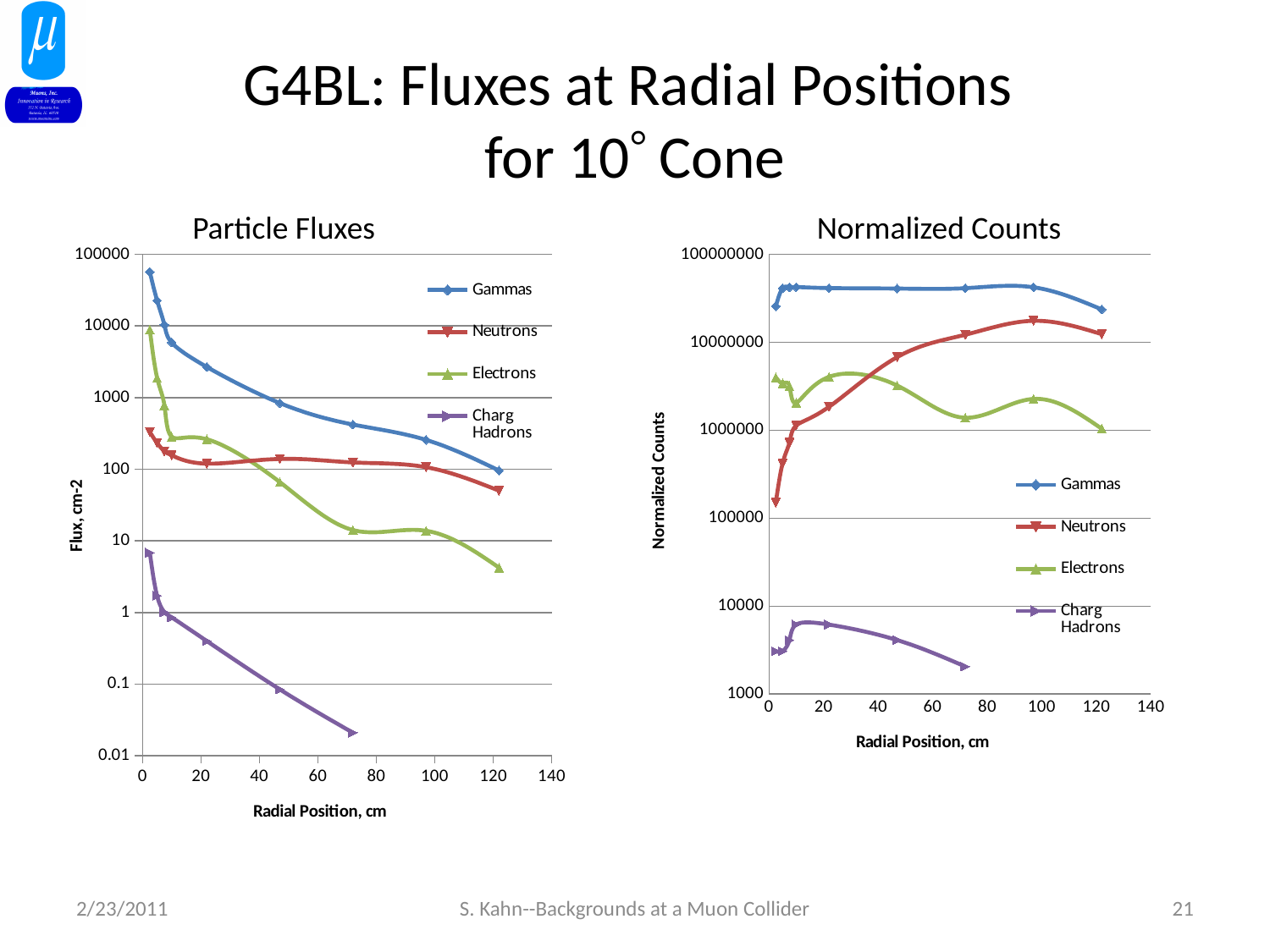
In the Particle Fluxes chart, do the Gammas values rise or fall as radial position increases? fall What kind of chart is the Particle Fluxes chart on the left? line chart In the Particle Fluxes chart, which series has the highest flux at the largest radial position (about 120 cm)? Gammas In the Particle Fluxes chart, is the Gammas flux at a radial position of about 20 cm greater or less than 1000? greater In the Normalized Counts chart, is the Charg Hadrons value at a radial position of about 70 cm greater or less than 10000? less In the Normalized Counts chart, at a radial position of about 100 cm, which is larger: Neutrons or Electrons? Neutrons What is the y-axis label of the Particle Fluxes chart? Flux, cm-2 In the Particle Fluxes chart, is the Charg Hadrons flux at a radial position of about 70 cm greater or less than 0.1? less How many series does the legend of the Normalized Counts chart list? 4 What is the x-axis label of the Normalized Counts chart? Radial Position, cm In the Normalized Counts chart, which series has the highest values across the radial positions? Gammas In the Particle Fluxes chart, which series has the lowest flux across the radial positions? Charg Hadrons